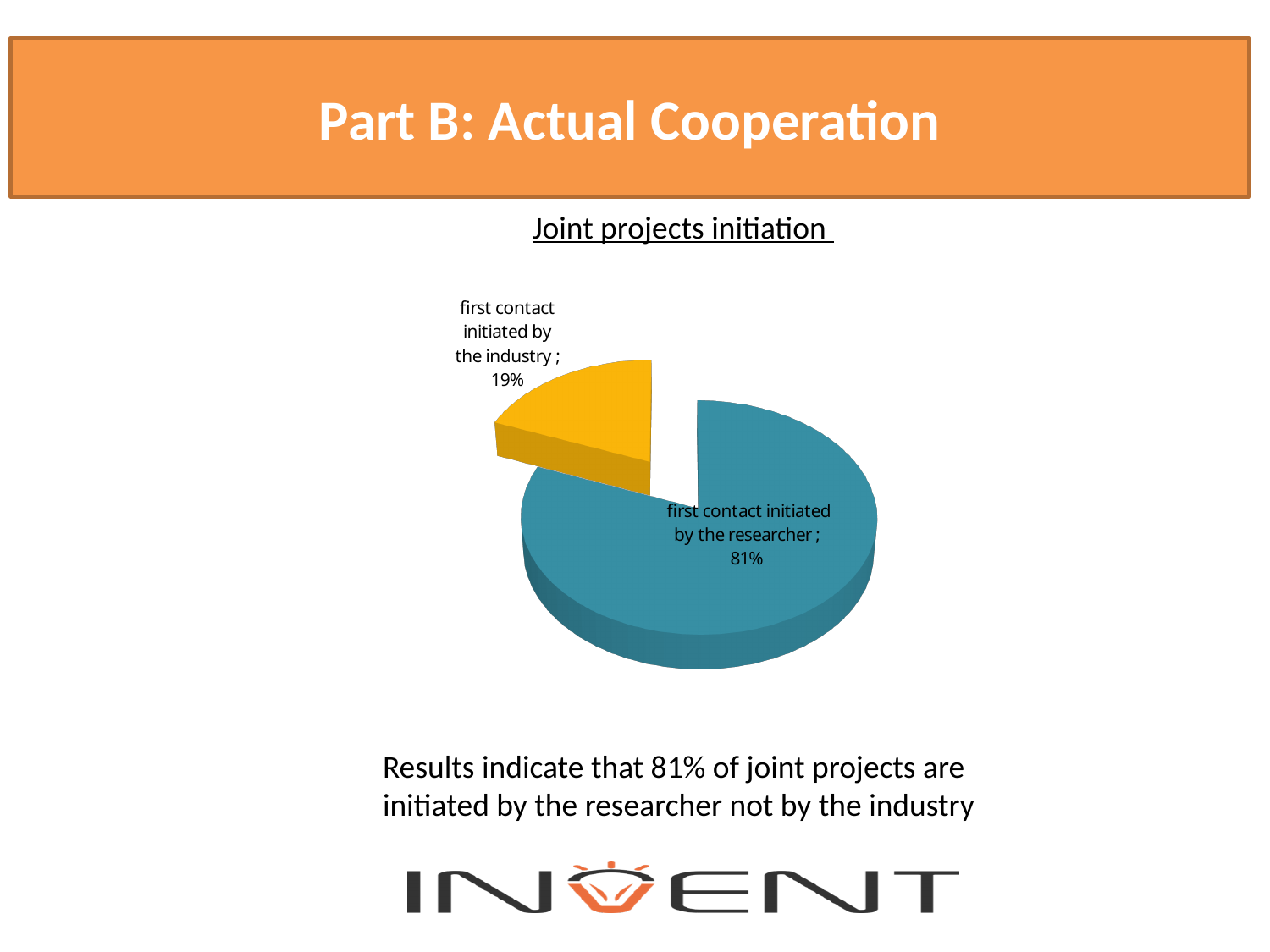
Which slice of the pie chart is the largest? first contact initiated by the researcher What is the total of the two slices shown in the pie chart? 100% How many slices does the pie chart have? 2 Which slice of the pie chart is the smallest? first contact initiated by the industry What share of joint projects had first contact initiated by the industry? 19% Which is larger: the share initiated by the researcher or the share initiated by the industry? first contact initiated by the researcher What is the difference in percentage points between the researcher-initiated and industry-initiated slices? 62 What kind of chart is shown on the slide? pie chart What colour is the slice for first contact initiated by the industry? yellow What share of joint projects had first contact initiated by the researcher? 81% What is the title of the chart? Joint projects initiation